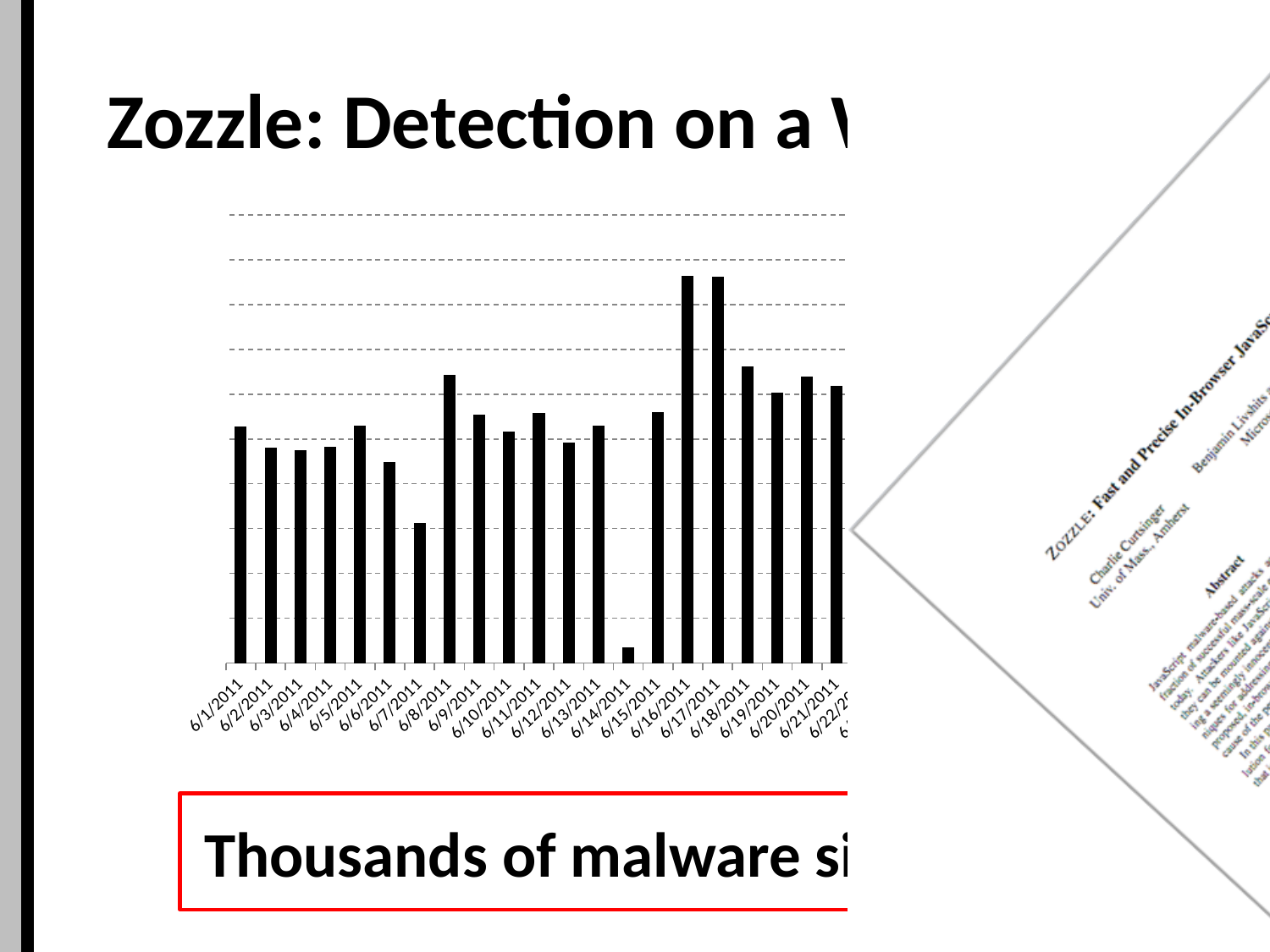
Which has the higher value, 6/8/2011 or 6/16/2011? 6/16/2011 What kind of chart is shown on the slide? bar chart Which has the higher value, 6/13/2011 or 6/14/2011? 6/13/2011 Which date has the lowest bar in the chart? 6/14/2011 What is the first date label on the x axis of the chart? 6/1/2011 Do the values rise or fall from 6/14/2011 to 6/16/2011? rise Which has the higher value, 6/1/2011 or 6/7/2011? 6/1/2011 Do the values rise or fall from 6/17/2011 to 6/19/2011? fall What colour are the bars in the chart? black